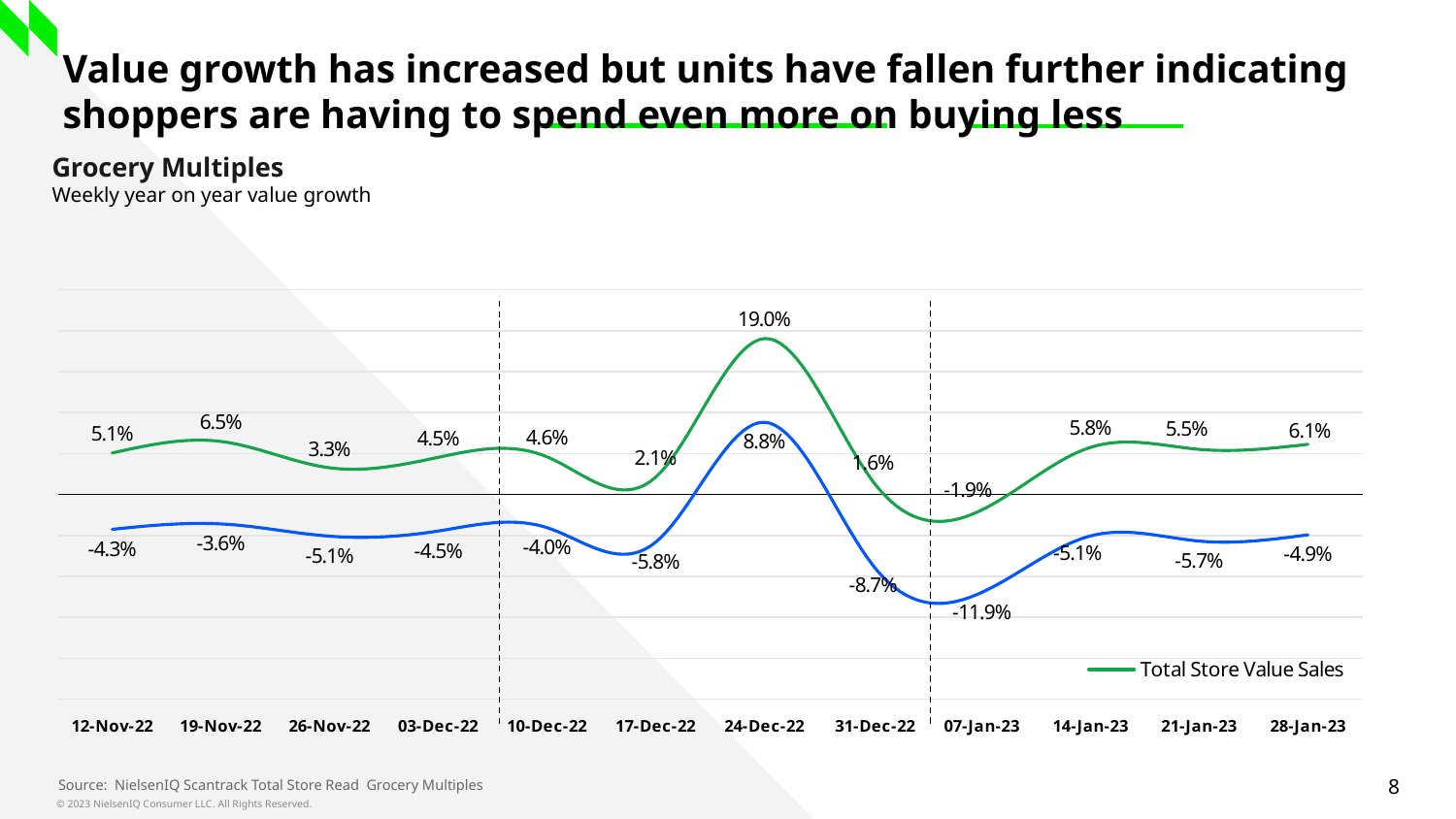
What is the Total Store Value Sales growth for the week of 17-Dec-22? 2.1% What is the difference in Total Store Value Sales growth between 24-Dec-22 and 31-Dec-22? 17.4 percentage points What kind of chart is shown on the slide? Line chart What is the Total Store Value Sales growth for the week of 07-Jan-23? -1.9% Does Total Store Value Sales growth rise or fall from 24-Dec-22 to 07-Jan-23? Fall How many weeks are shown on the x axis of the chart? 12 Which week has the highest Total Store Value Sales growth? 24-Dec-22 What is the difference in Total Store Value Sales growth between 19-Nov-22 and 26-Nov-22? 3.2 percentage points What is the Total Store Value Sales growth for the week of 24-Dec-22? 19.0% How many series does the chart legend list? 1 Which week has the higher Total Store Value Sales growth, 12-Nov-22 or 28-Jan-23? 28-Jan-23 Which week has the lowest Total Store Value Sales growth? 07-Jan-23